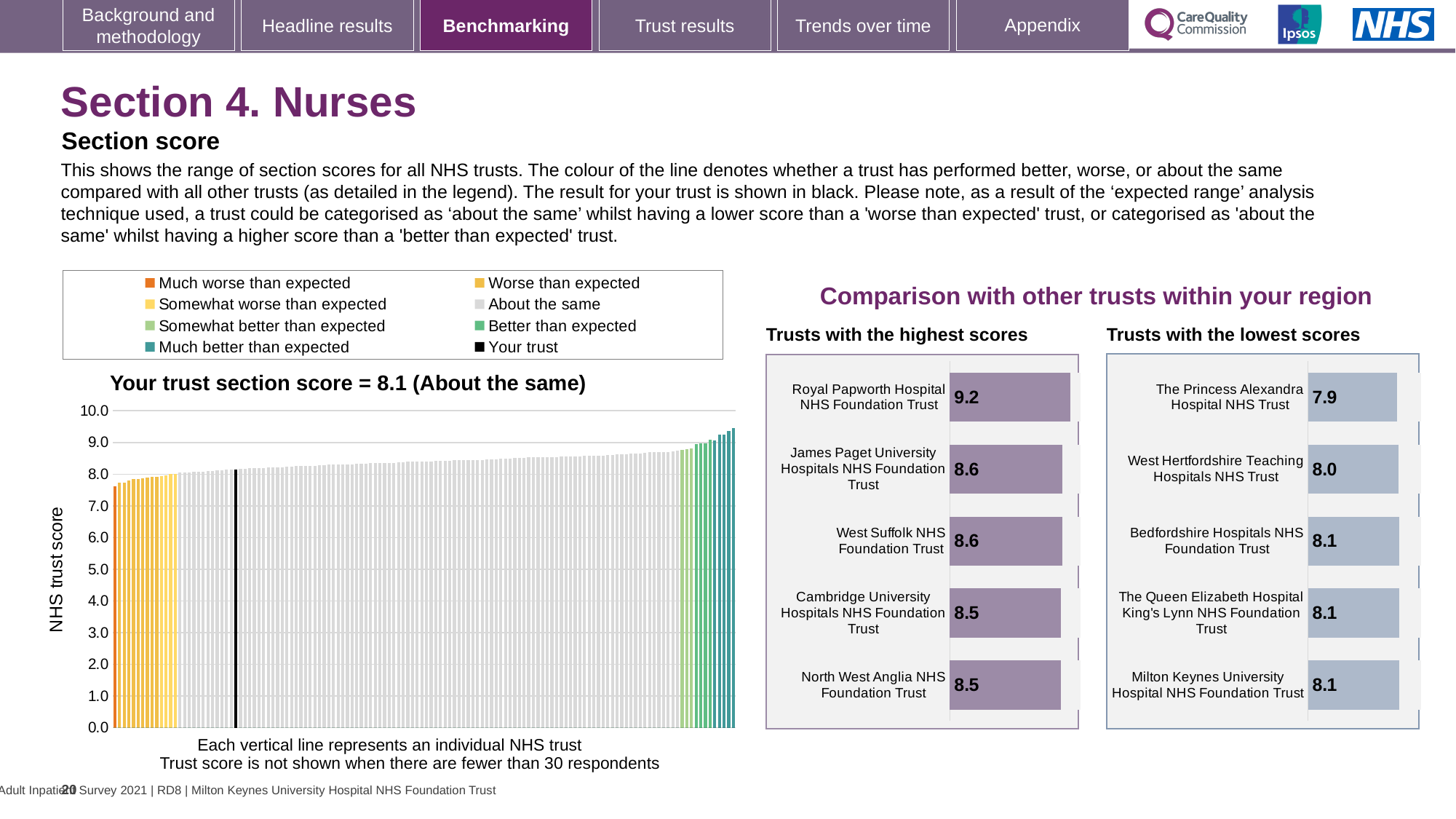
On the 'Your trust section score' chart, what kind of chart is used to show the range of section scores? Bar chart On the 'Trusts with the highest scores' chart, which trust has the highest score? Royal Papworth Hospital NHS Foundation Trust On the 'Your trust section score' chart, is the value of the highest bar greater or less than 9.0? greater On the 'Trusts with the lowest scores' chart, which trust has the lowest score? The Princess Alexandra Hospital NHS Trust On the 'Trusts with the lowest scores' chart, how many trusts are shown? 5 On the 'Trusts with the highest scores' chart, what is the difference between the scores of Royal Papworth Hospital NHS Foundation Trust and Cambridge University Hospitals NHS Foundation Trust? 0.7 On the 'Your trust section score' chart, do the trust scores rise or fall from left to right along the x axis? Rise On the 'Your trust section score' chart, what is the label of the y axis? NHS trust score On the 'Trusts with the lowest scores' chart, what is the score for West Hertfordshire Teaching Hospitals NHS Trust? 8.0 On the 'Trusts with the highest scores' chart, what is the score for North West Anglia NHS Foundation Trust? 8.5 On the 'Your trust section score' chart, what is the section score for your trust? 8.1 On the 'Your trust section score' chart, how many entries does the legend list? 8